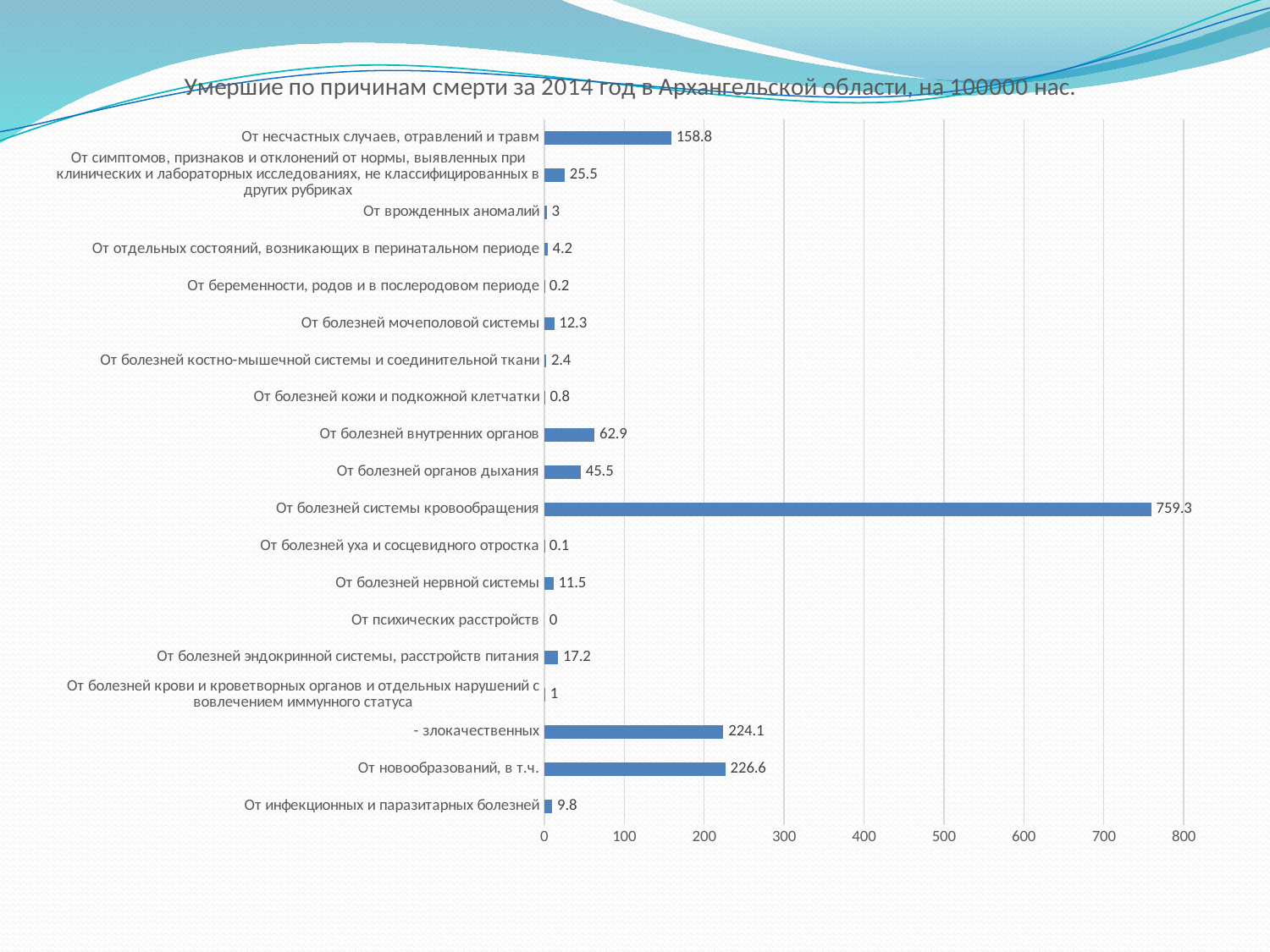
What kind of chart is shown on the slide? bar chart What is the value for «От несчастных случаев, отравлений и травм»? 158.8 Is the value for «От болезней системы кровообращения» greater or less than 700? greater What is the difference between the values for «От новообразований, в т.ч.» and «- злокачественных»? 2.5 What is the difference between the values for «От несчастных случаев, отравлений и травм» and «От болезней внутренних органов»? 95.9 Which cause of death has the highest value on the chart? От болезней системы кровообращения Which is larger: the value for «От болезней внутренних органов» or for «От болезней органов дыхания»? От болезней внутренних органов What is the value for «От болезней органов дыхания»? 45.5 What is the title of the chart? Умершие по причинам смерти за 2014 год в Архангельской области, на 100000 нас. Which cause of death has the lowest value on the chart? От психических расстройств How many categories (causes of death) are shown on the chart? 19 What is the value for «От болезней системы кровообращения»? 759.3